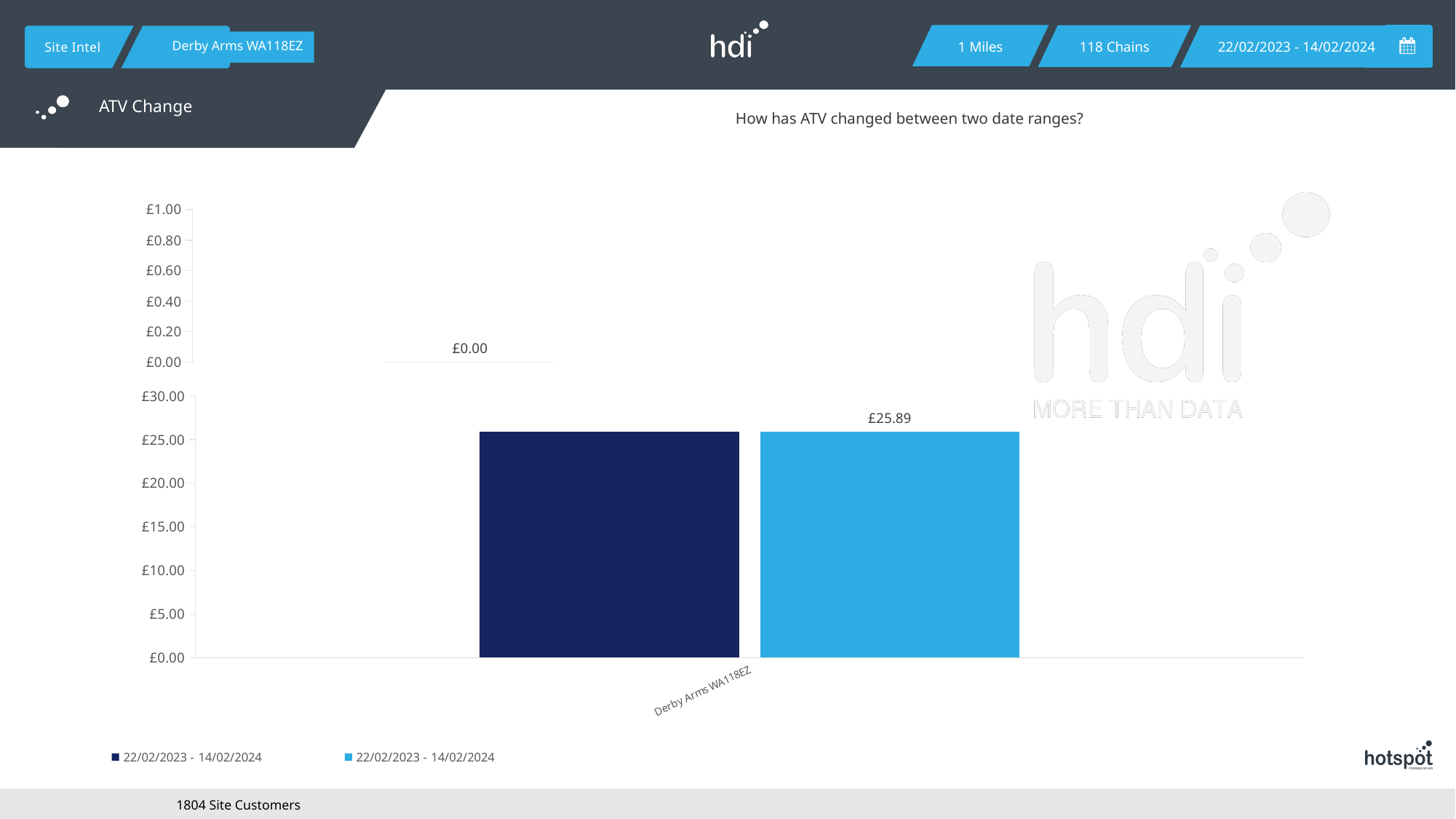
What value is labelled on the upper chart? £0.00 How many categories are shown on the x axis of the lower chart? 1 In the lower chart, is the value of the dark blue bar for Derby Arms WA118EZ greater or less than £10.00? greater What is the category label on the x axis of the lower chart? Derby Arms WA118EZ What kind of chart is the lower chart on the slide? bar chart In the lower chart, is the value of the light blue bar for Derby Arms WA118EZ greater or less than £30.00? less What is the title shown in the header band above the charts? ATV Change How many series does the legend of the lower chart list? 2 In the upper chart, is the labelled value greater or less than £0.20? less In the lower chart, what value is labelled on the light blue bar for Derby Arms WA118EZ? £25.89